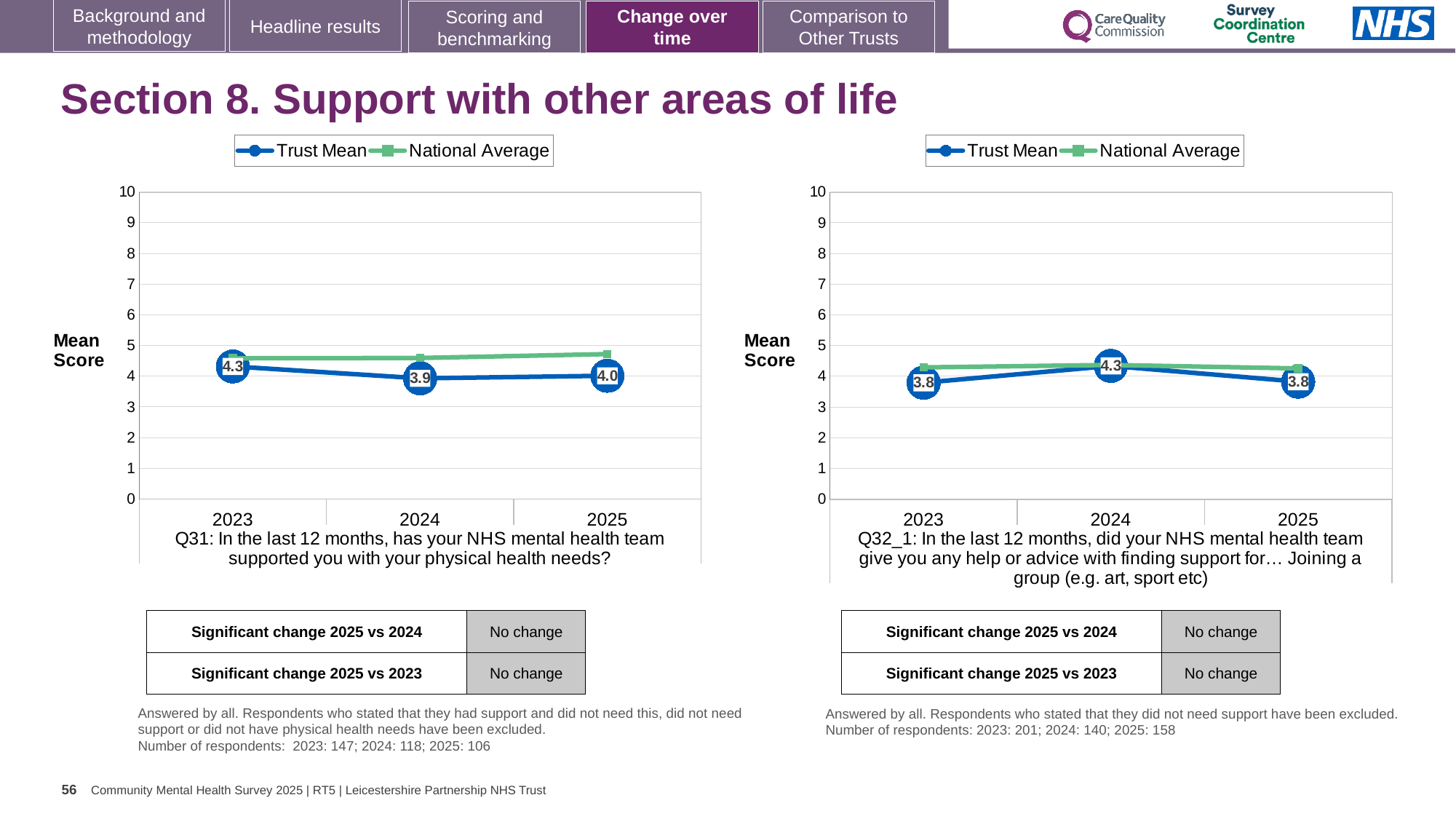
How many series does the legend of the right chart (Q32_1) list? 2 How many years are plotted on the x axis of the left chart (Q31)? 3 On the left chart (Q31), is the Trust Mean for 2025 greater or less than 5? less What kind of chart is the left chart (Q31)? Line chart On the left chart (Q31), what is the difference between the Trust Mean in 2023 and in 2024? 0.4 On the left chart (Q31), what is the Trust Mean for 2024? 3.9 On the right chart (Q32_1), what is the difference between the Trust Mean in 2024 and in 2023? 0.5 On the left chart (Q31), what is the Trust Mean for 2023? 4.3 On the right chart (Q32_1), what is the Trust Mean for 2025? 3.8 On the right chart (Q32_1), what is the Trust Mean for 2024? 4.3 On the left chart (Q31), which year has the lowest Trust Mean? 2024 On the right chart (Q32_1), which year has the highest Trust Mean? 2024